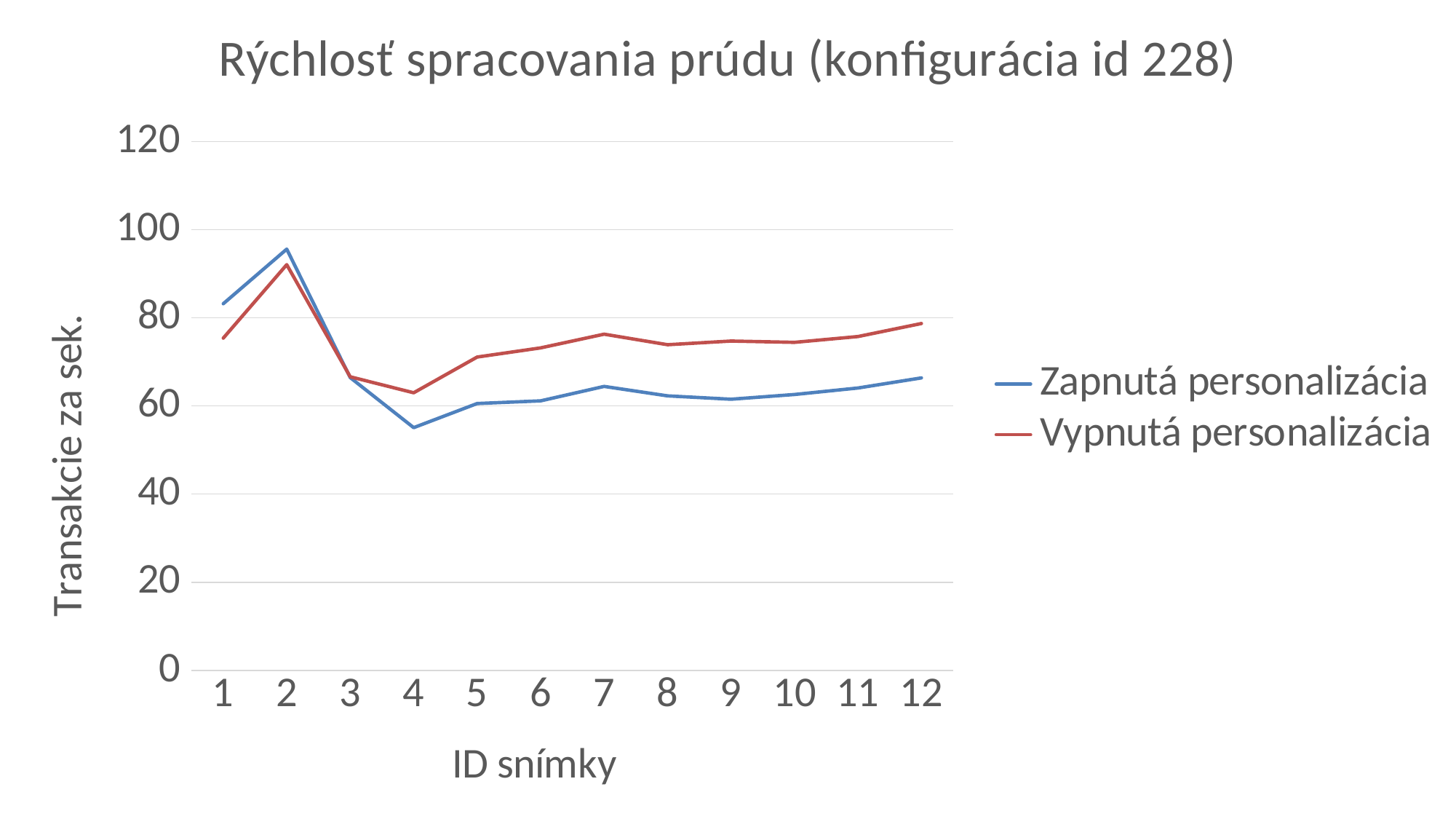
At which ID snímky does the Vypnutá personalizácia series reach its highest value? 2 How many snapshot IDs are plotted along the x axis? 12 Is the value for Zapnutá personalizácia at ID snímky 4 greater or less than 60? less How many series does the legend list? 2 At ID snímky 7, which series has the larger value, Zapnutá personalizácia or Vypnutá personalizácia? Vypnutá personalizácia What is the title of the chart? Rýchlosť spracovania prúdu (konfigurácia id 228) Is the value for Vypnutá personalizácia at ID snímky 7 greater or less than 60? greater Between ID snímky 2 and ID snímky 4, does the Zapnutá personalizácia series rise or fall? fall Is the value for Vypnutá personalizácia at ID snímky 2 greater or less than 80? greater What kind of chart is shown on the slide? line chart At which ID snímky does the Zapnutá personalizácia series reach its lowest value? 4 At which ID snímky does the Zapnutá personalizácia series reach its highest value? 2